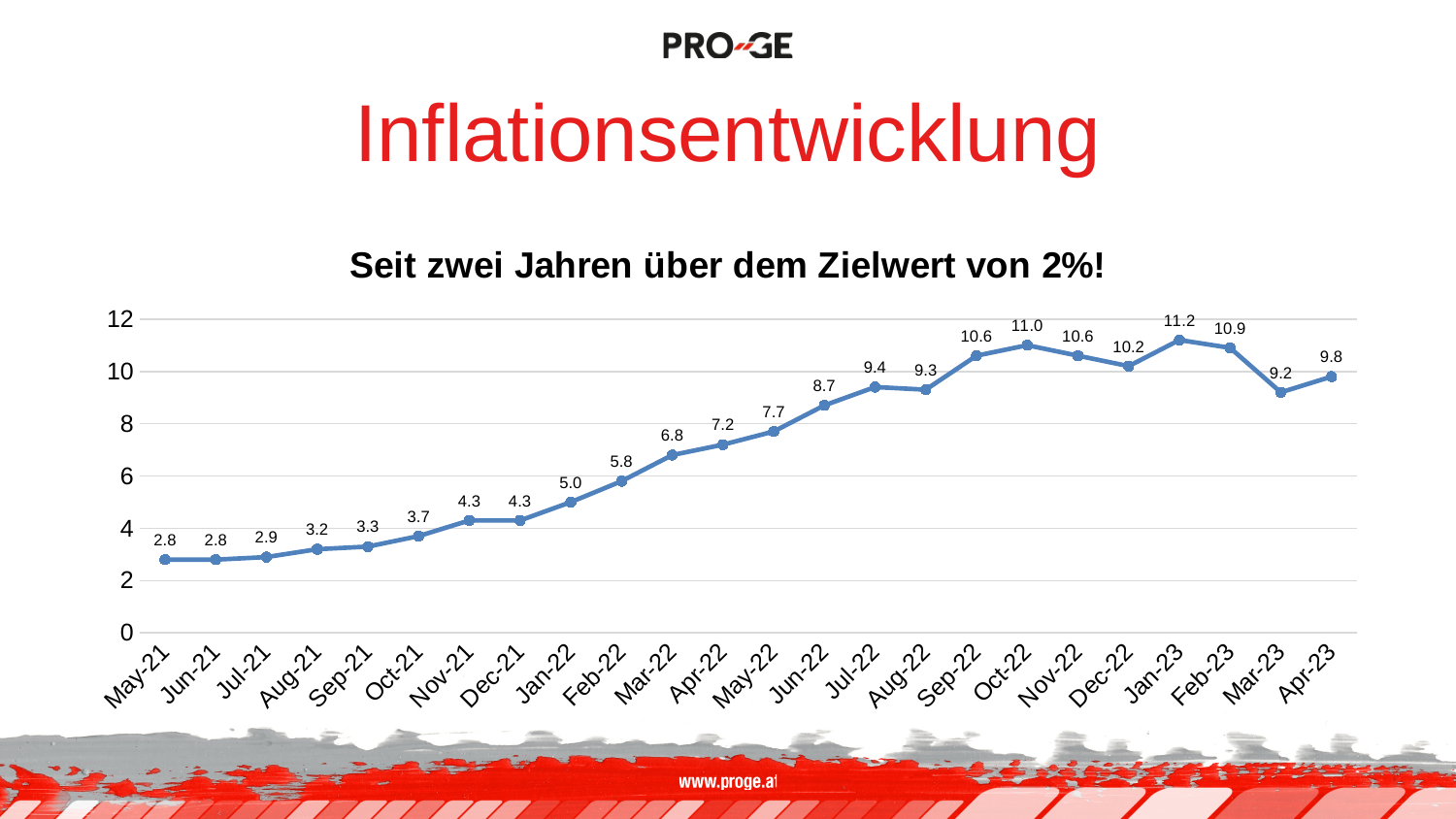
Which month has the highest value? Jan-23 What is the value for Jan-23? 11.2 What is the subtitle shown above the chart? Seit zwei Jahren über dem Zielwert von 2%! What is the value for Oct-22? 11.0 What type of chart is shown on the slide? line chart Which is larger, the value for Jul-22 or the value for Aug-22? Jul-22 What is the value for Jan-22? 5.0 What is the difference between the values for Jan-23 and Mar-23? 2.0 What is the value for Apr-23? 9.8 How many data points are plotted on the chart? 24 Is the value for Sep-22 greater or less than 10? greater What is the difference between the values for Apr-23 and May-21? 7.0